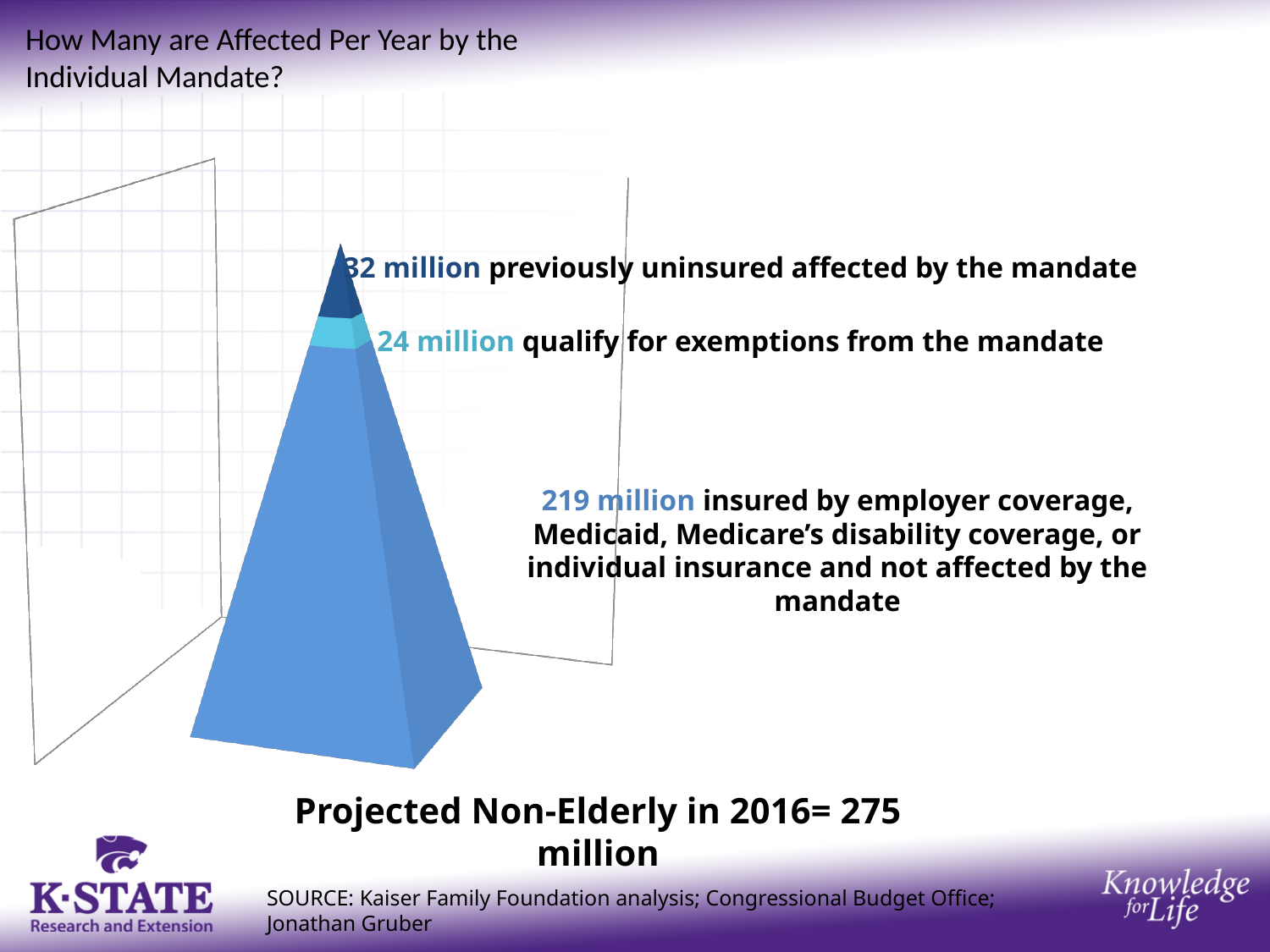
What is the title of the slide? How Many are Affected Per Year by the Individual Mandate? What kind of chart is shown on the slide? pyramid chart How many people are projected to qualify for exemptions from the mandate? 24 million Which is larger: the group not affected by the mandate or the group qualifying for exemptions? the group not affected by the mandate What is the difference between the 219 million not affected by the mandate and the 24 million qualifying for exemptions? 195 million What colour is the largest (bottom) segment of the pyramid? blue What is the projected total non-elderly population in 2016 shown below the pyramid? 275 million How many people are insured by employer coverage, Medicaid, Medicare's disability coverage, or individual insurance and not affected by the mandate? 219 million Which segment of the pyramid represents the largest group? insured and not affected by the mandate (219 million) How many segments does the pyramid have? 3